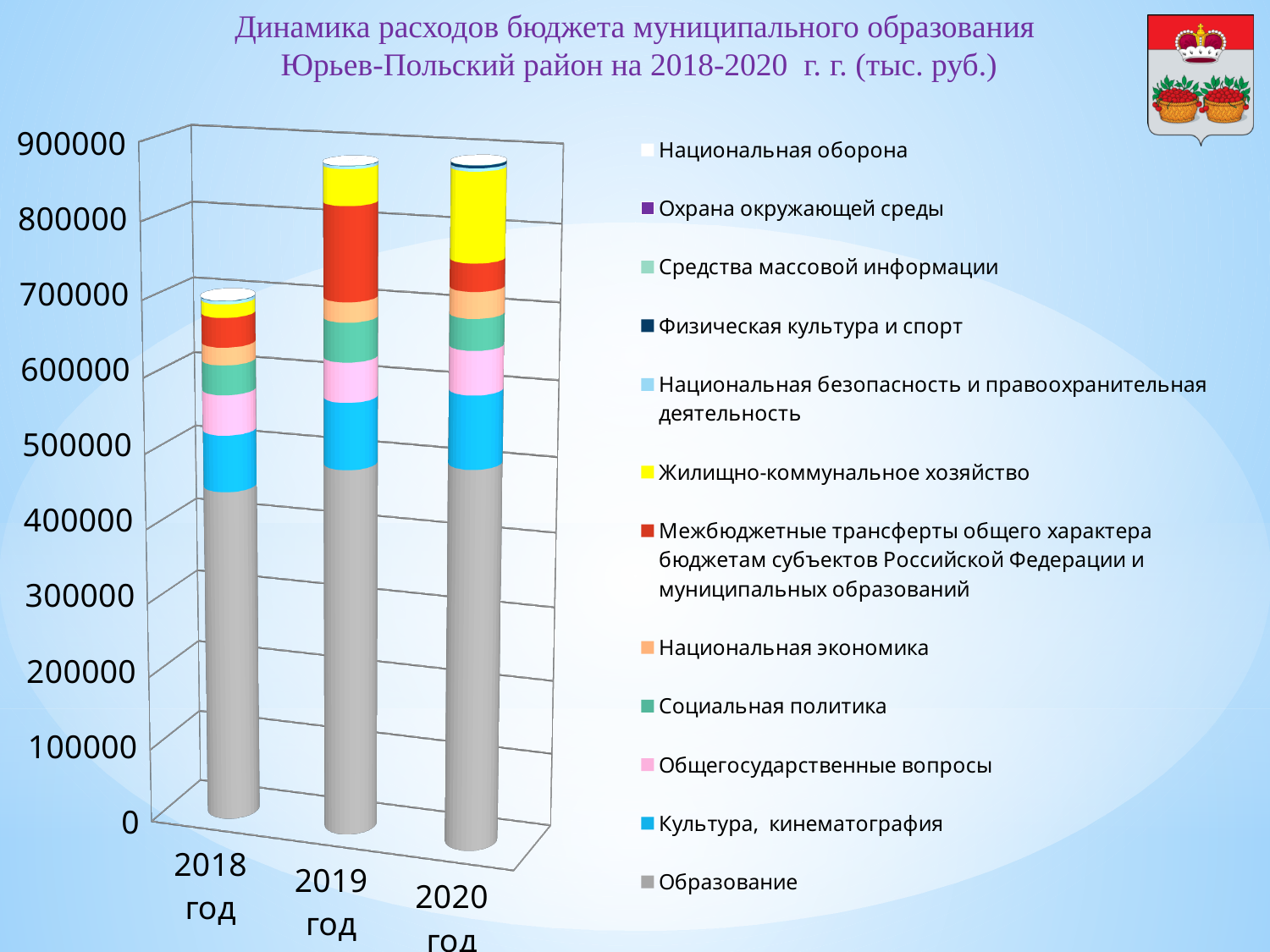
How many series does the legend list? 12 What is the first year shown on the x axis? 2018 год How many years (categories) are plotted on the x axis? 3 What kind of chart is shown on the slide? Stacked bar chart Which year has the lowest total budget expenditure? 2018 год Is the Образование segment for 2018 greater or less than 400000? greater Which is larger, the total for 2018 or the total for 2019? 2019 Which series is shown in yellow in the legend? Жилищно-коммунальное хозяйство Is the total for 2019 greater or less than 800000? greater Is the total for 2018 greater or less than 600000? greater Which series forms the largest segment of each bar? Образование